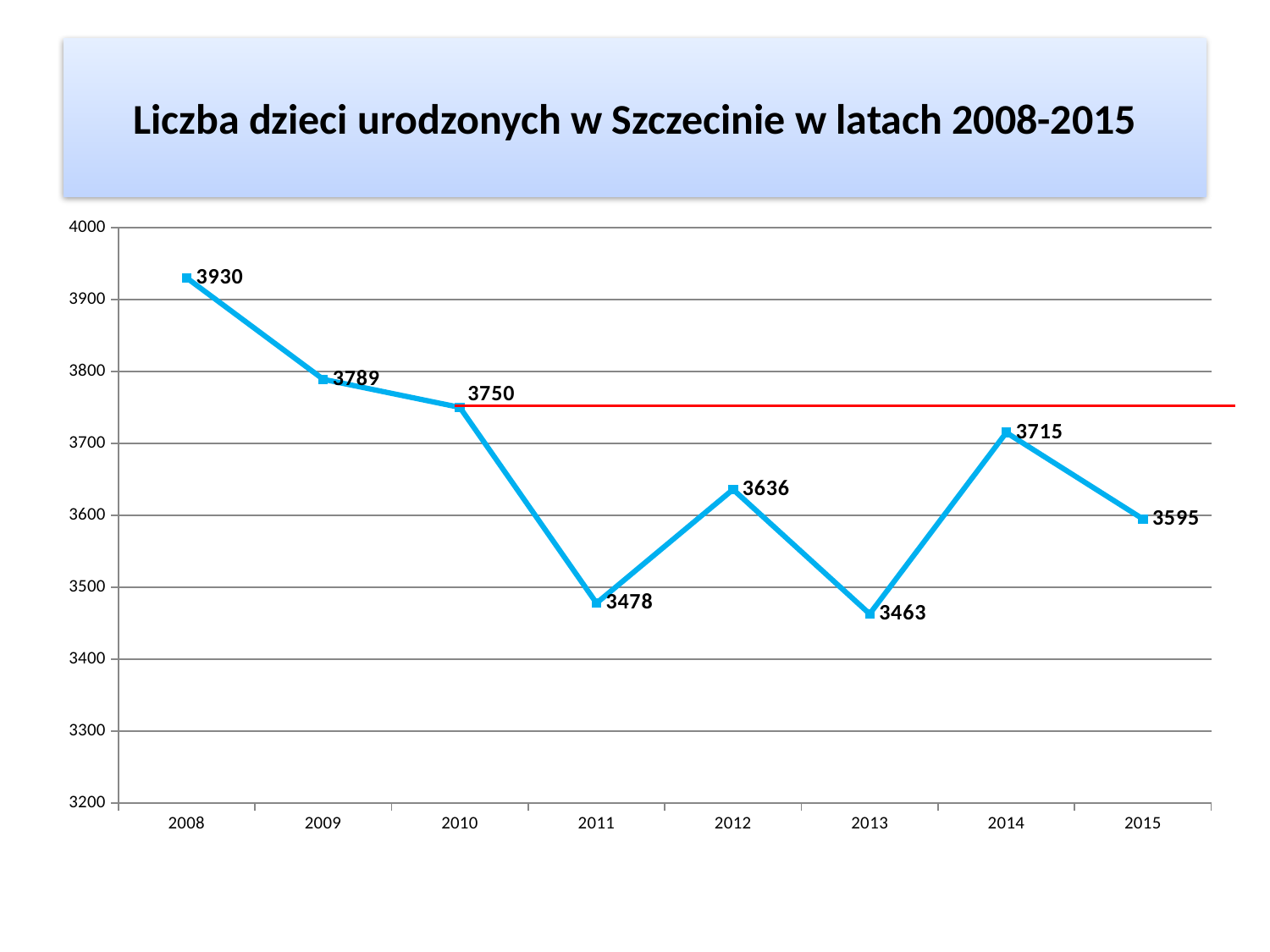
Is the value for 2011 greater or less than 3500? less Do the values rise or fall from 2008 to 2011? fall What value is shown for 2013? 3463 Which year has the lowest value? 2013 What is the number of children born in Szczecin in 2008? 3930 How many years are plotted on the chart? 8 What value is shown for 2015? 3595 Which year has the highest value? 2008 What is the difference between the values for 2014 and 2013? 252 What kind of chart is shown on the slide? line chart What is the difference between the values for 2008 and 2015? 335 Which is larger, the value for 2012 or the value for 2014? 2014